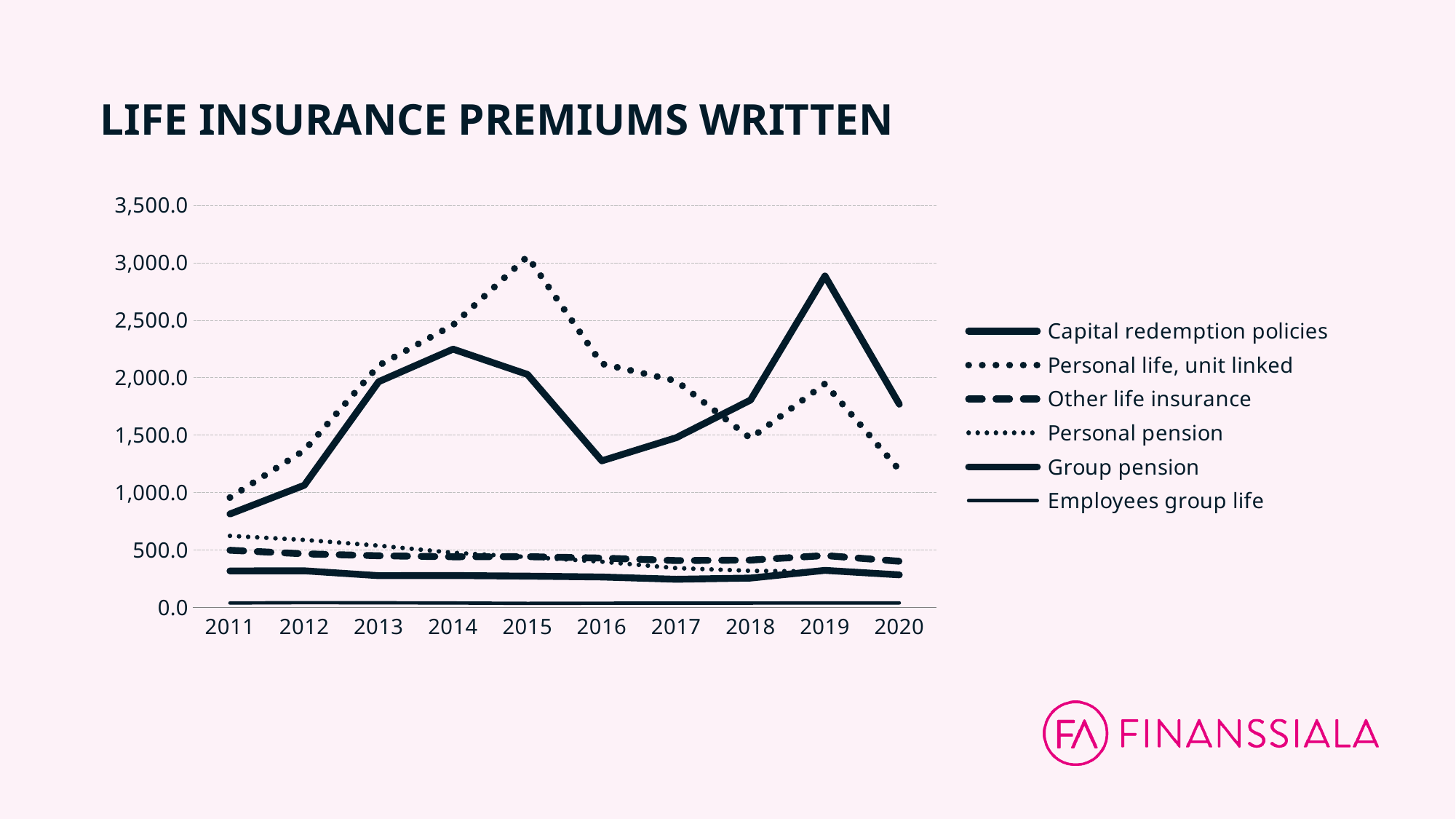
In which year does the Personal life, unit linked series reach its highest value? 2015 Is the value for Capital redemption policies in 2019 greater or less than 2,500.0? greater Does the Personal life, unit linked series rise or fall from 2015 to 2018? fall Which series has the lowest values across all years shown? Employees group life How many years are shown on the x axis? 10 Is the value for Personal life, unit linked in 2015 greater or less than 2,500.0? greater What is the title of the chart? LIFE INSURANCE PREMIUMS WRITTEN In which year does the Capital redemption policies series reach its highest value? 2019 In 2020, which is higher: Capital redemption policies or Personal life, unit linked? Capital redemption policies Is the value for Capital redemption policies in 2016 greater or less than 1,500.0? less What kind of chart is shown on the slide? line chart How many series does the legend list? 6